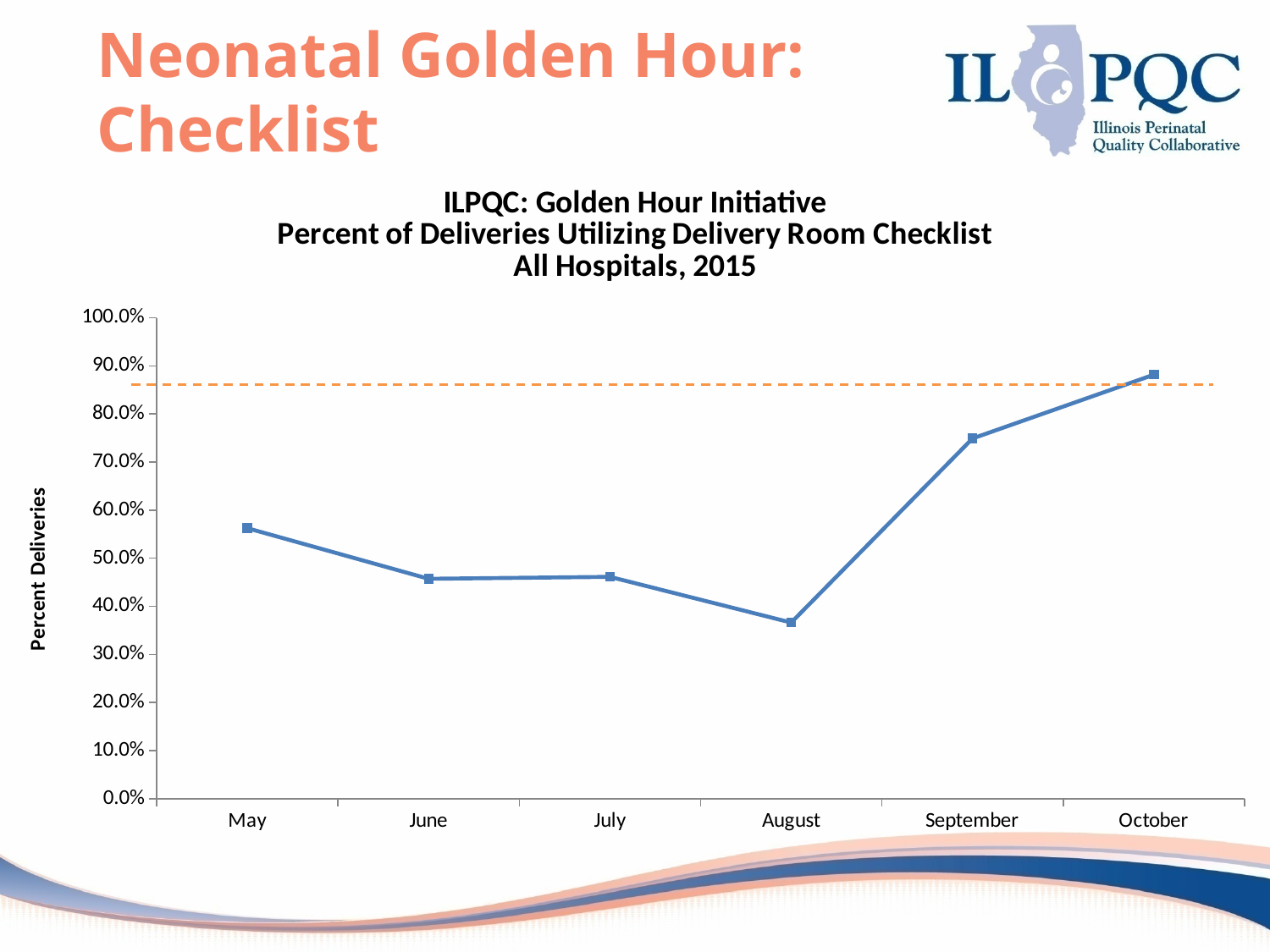
Is the value for August greater or less than 40.0%? less Is the value for September greater or less than 70.0%? greater Is the value for May greater or less than 50.0%? greater What kind of chart is shown on the slide? line chart Which month has the lowest percent of deliveries utilizing the delivery room checklist? August How many months are plotted on the x axis? 6 Which month has a higher value, September or May? September What is the label on the vertical axis of the chart? Percent Deliveries Which month has the highest percent of deliveries utilizing the delivery room checklist? October Do the values rise or fall from August to October? rise